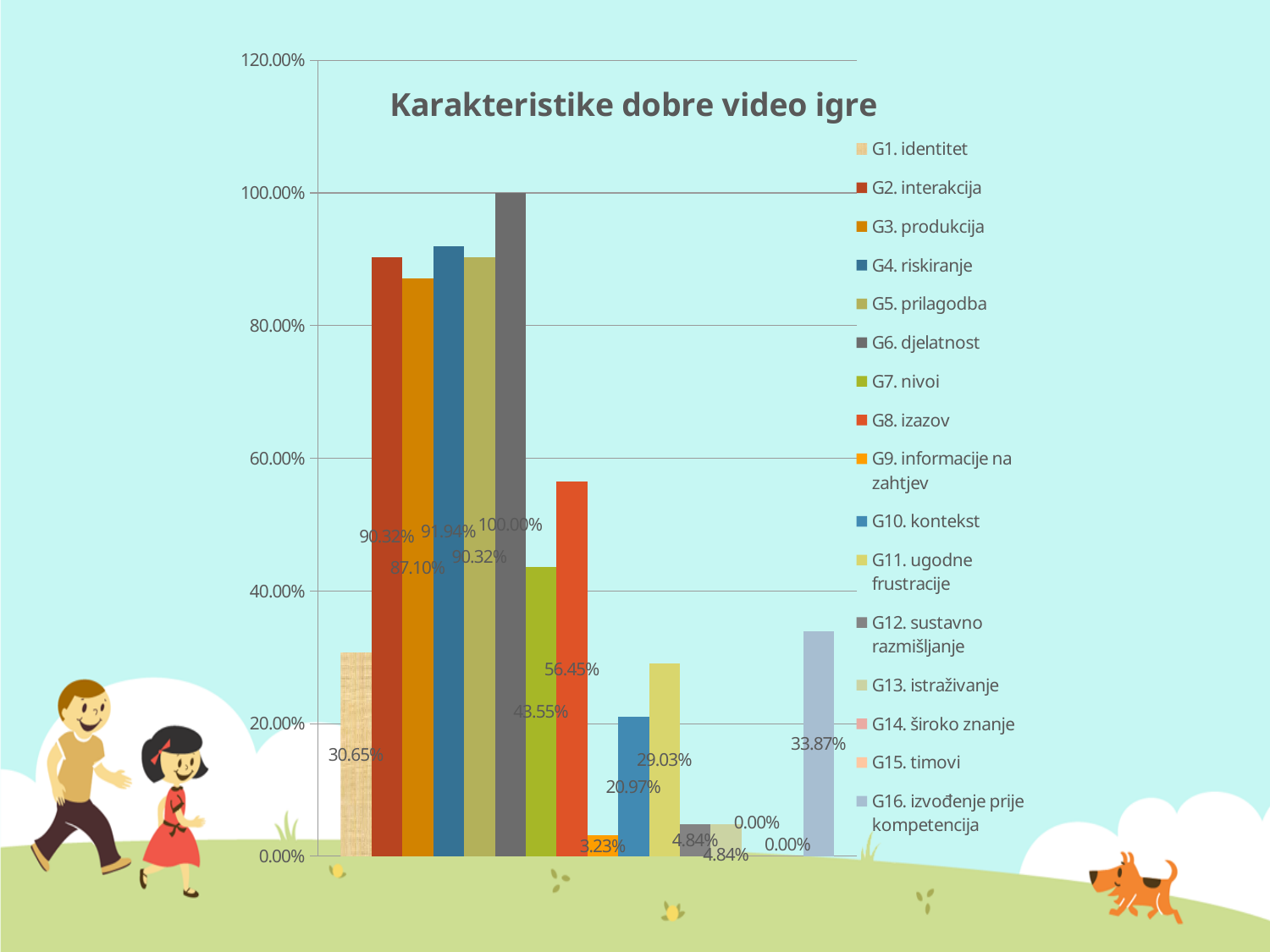
Which series has the highest value? G6. djelatnost What is the value for G1. identitet? 30.65% What is the title of the chart? Karakteristike dobre video igre What is the value for G9. informacije na zahtjev? 3.23% Is the value for G7. nivoi greater or less than 40.00%? greater How many series does the legend list? 16 What is the difference between the values for G16. izvođenje prije kompetencija and G1. identitet? 3.22% What is the value for G16. izvođenje prije kompetencija? 33.87% What is the value for G6. djelatnost? 100.00% Which is larger, the value for G4. riskiranje or G3. produkcija? G4. riskiranje What is the difference between the values for G6. djelatnost and G8. izazov? 43.55% What is the value for G8. izazov? 56.45%